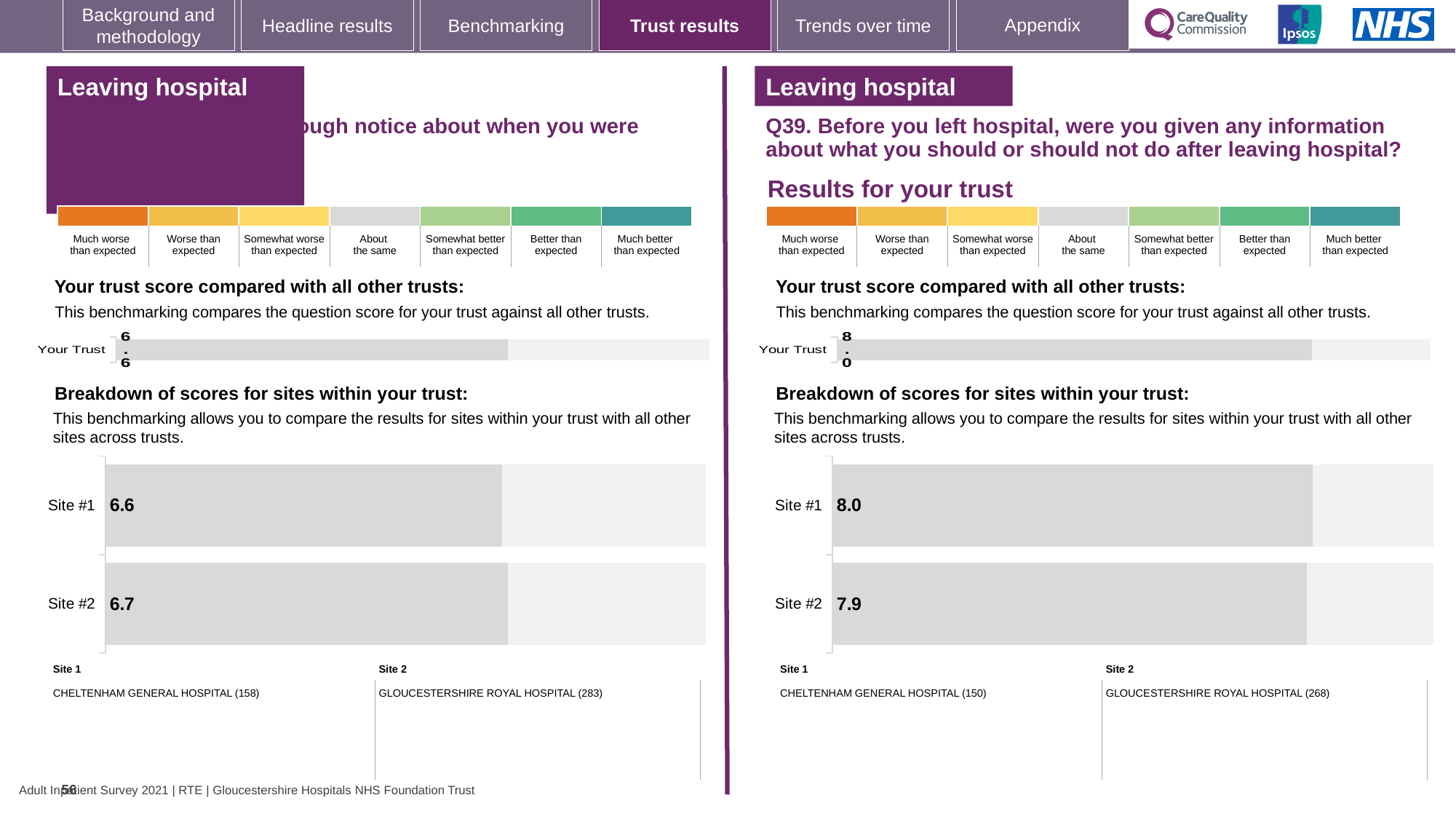
On the right-hand (Q39) side, what is the difference between the Site #1 and Site #2 scores in the site breakdown chart? 0.1 On the right-hand (Q39) side, what is the score shown for Site #2 in the breakdown of scores for sites within your trust? 7.9 On the left-hand side of the slide, how many sites are shown in the breakdown of scores for sites within your trust chart? 2 On the right-hand (Q39) side, what is the score shown for Site #1 in the breakdown of scores for sites within your trust? 8.0 On the right-hand (Q39) side, what is the value shown for Your Trust in the 'Your trust score compared with all other trusts' chart? 8.0 On the left-hand side of the slide, what is the score shown for Site #2 in the breakdown of scores for sites within your trust? 6.7 What kind of chart is used for the breakdown of scores for sites within your trust on the right-hand (Q39) side? Bar chart On the left-hand side of the slide, which site has the lower score in the breakdown of scores for sites within your trust? Site #1 On the left-hand side of the slide, what is the value shown for Your Trust in the 'Your trust score compared with all other trusts' chart? 6.6 On the right-hand (Q39) side, which site has the higher score in the breakdown of scores for sites within your trust? Site #1 On the left-hand side of the slide, what is the score shown for Site #1 in the breakdown of scores for sites within your trust? 6.6 On the right-hand (Q39) side, which hospital is listed as Site 2 below the site breakdown chart? GLOUCESTERSHIRE ROYAL HOSPITAL (268)